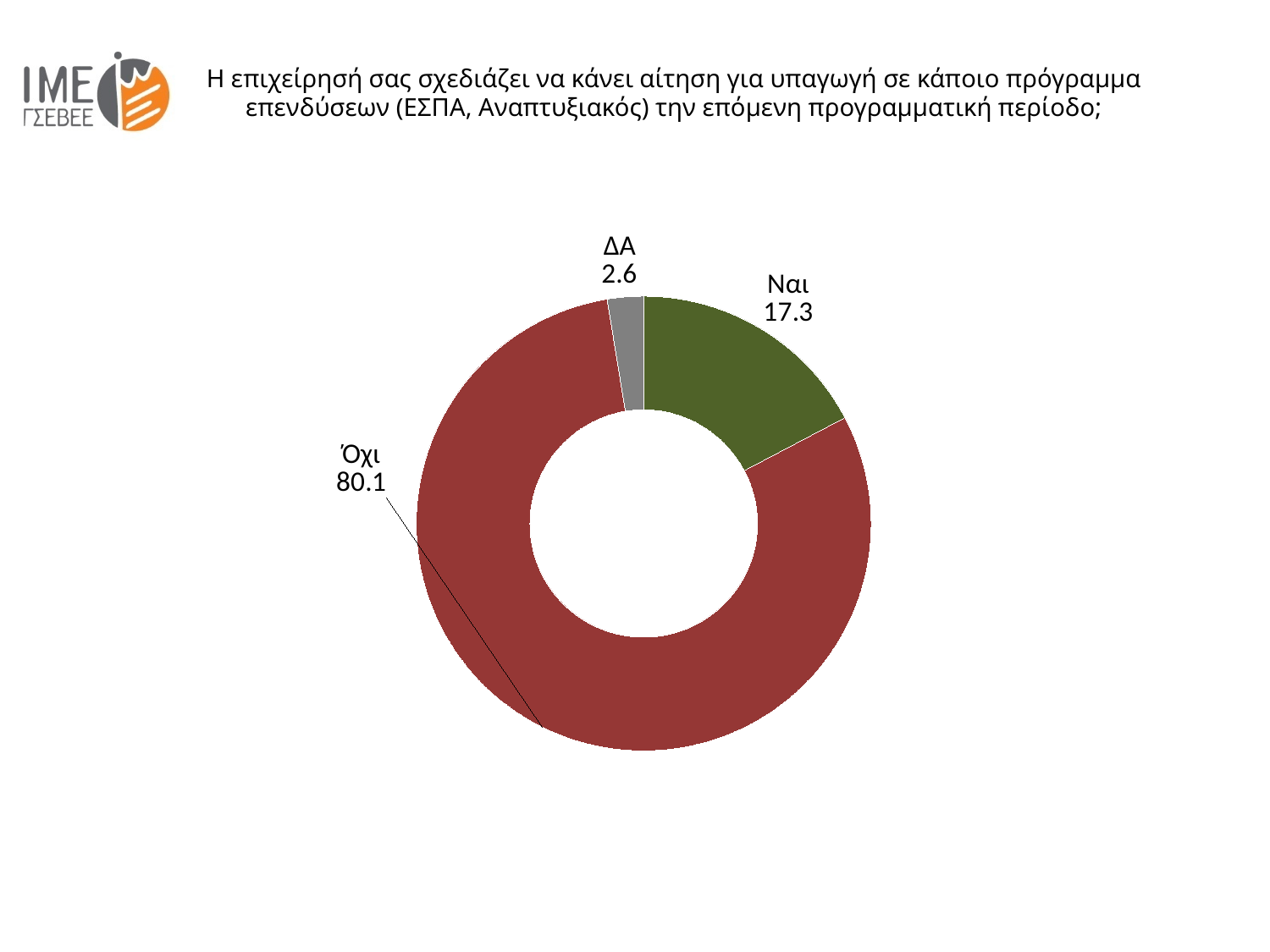
Which is larger, the value for Ναι or the value for ΔΑ? Ναι Which category has the smallest slice? ΔΑ What value is shown for the Όχι slice? 80.1 What is the difference between the values for Όχι and Ναι? 62.8 What colour is the Ναι slice? Green Which category has the largest slice? Όχι What is the total of the three values shown in the chart? 100 What is the difference between the values for Ναι and ΔΑ? 14.7 What value is shown for the ΔΑ slice? 2.6 What kind of chart is shown on the slide? Doughnut (pie) chart What value is shown for the Ναι slice? 17.3 How many categories are shown in the chart? 3